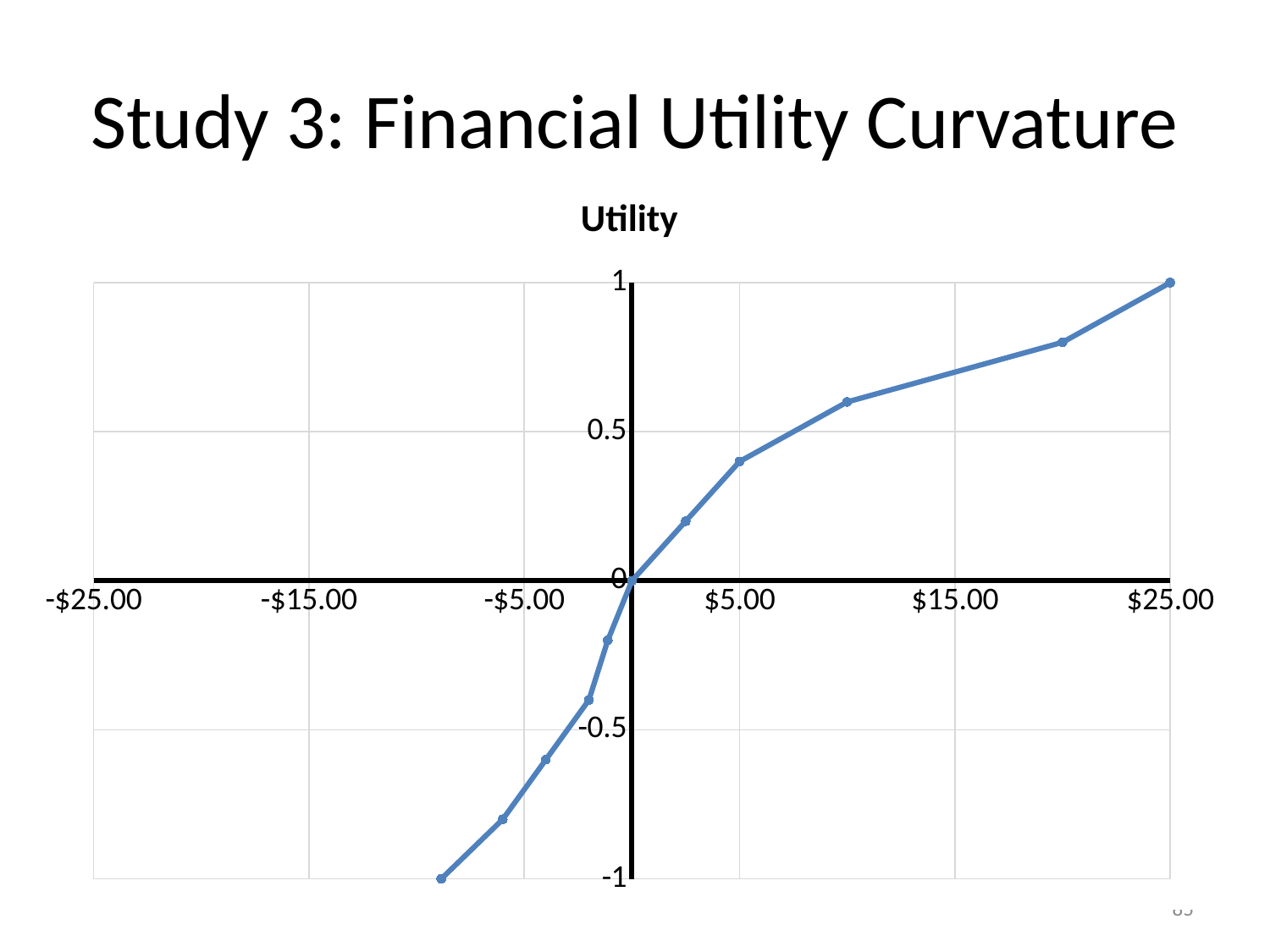
Which has the larger utility value, $5.00 or $20.00? $20.00 Does utility rise or fall as the dollar amount increases along the x axis? rise Is the utility value at $5.00 greater or less than 0.5? less What is the lowest utility value plotted on the chart? -1 How many data points are plotted on the line? 11 What is the highest utility value plotted on the chart? 1 What kind of chart is shown on the slide? line chart What is the utility value at $25.00? 1 Is the utility value at $20.00 greater or less than 0.5? greater What is the utility value at $0? 0 What is the title of the chart? Utility What are the minimum and maximum values labelled on the x axis? -$25.00 and $25.00